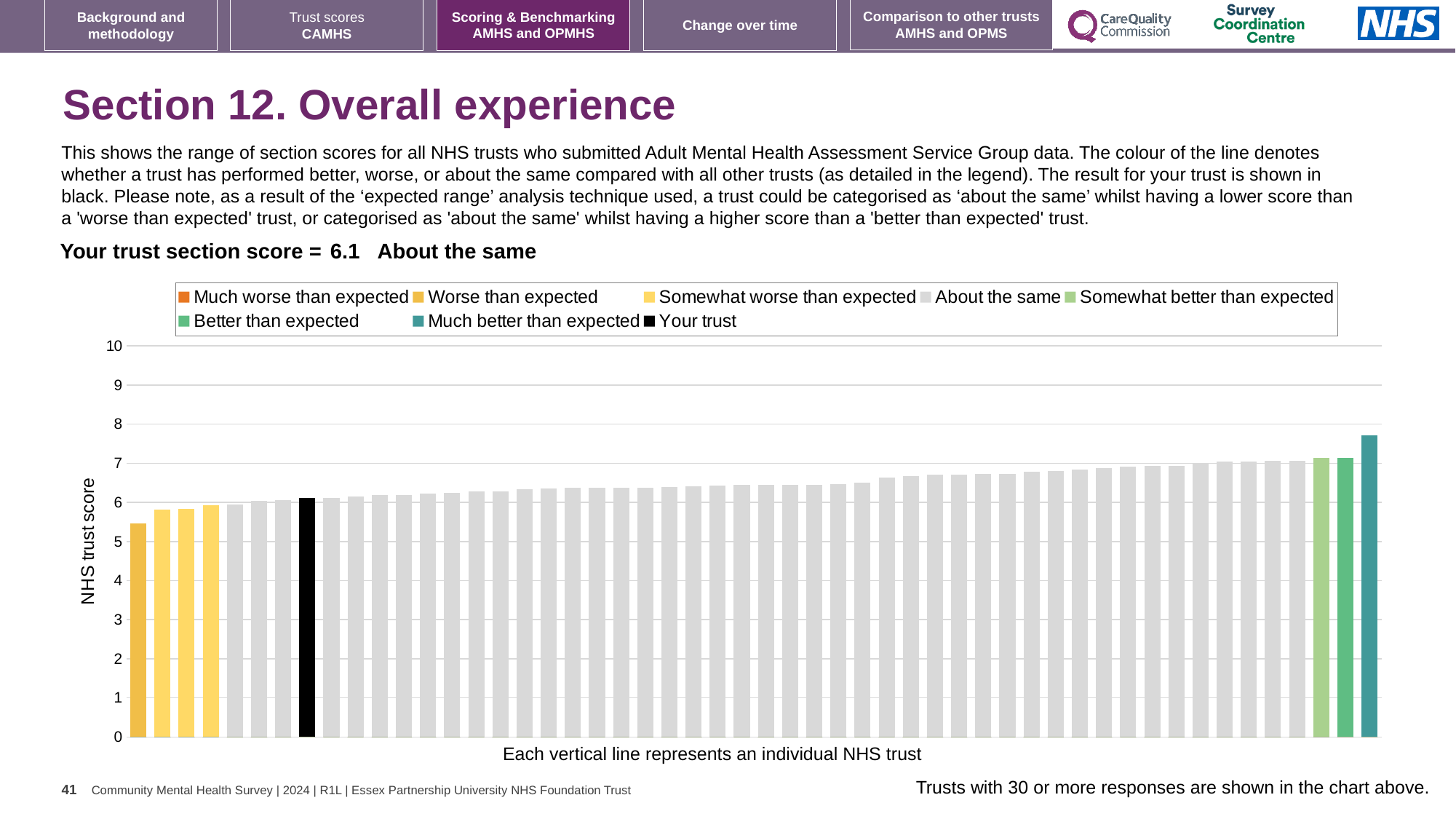
Is the value of the 'Your trust' bar greater or less than 5? greater Do the bar values rise or fall from left to right along the x axis? rise Which legend category does the tallest bar belong to? Much better than expected Is the 'Your trust' bar taller or shorter than the rightmost bar? shorter What kind of chart is shown on the slide? bar chart Is the value of the shortest bar (leftmost) greater or less than 6? less Which category is your trust placed in according to the slide? About the same How many entries does the chart legend list? 8 Is the value of the tallest bar (rightmost) greater or less than 7? greater What is the section score for your trust shown on the slide? 6.1 What is the label on the vertical axis of the chart? NHS trust score What colour is the bar representing your trust? black